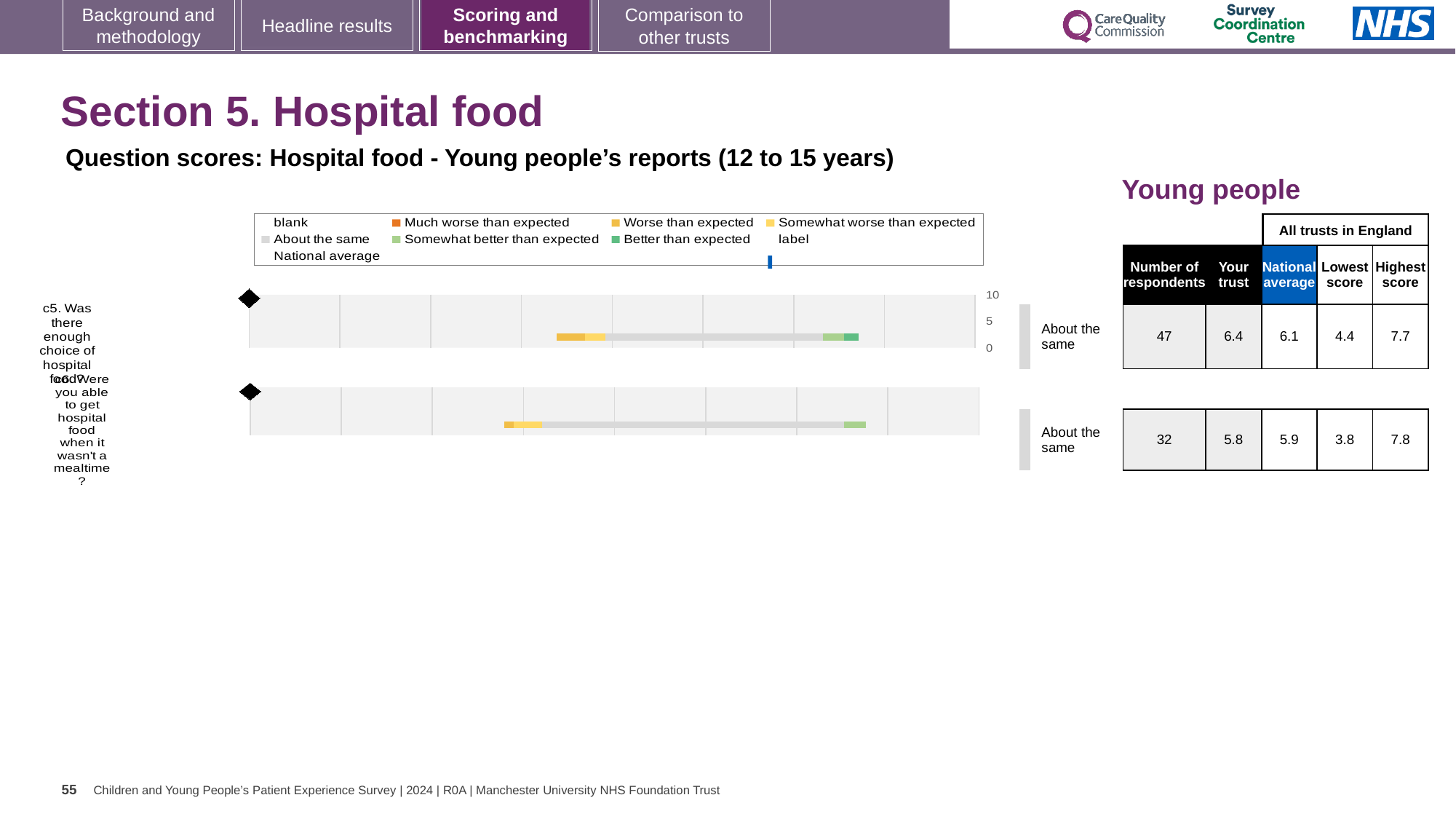
What kind of chart is used to show the question scores for hospital food? bar chart Which question had more respondents, c5 or c6? c5 What is the difference between the highest score and the lowest score for question c5? 3.3 What is the national average score for question c5 (Was there enough choice of hospital food?)? 6.1 How many survey questions are plotted in the hospital food chart? 2 What is the 'Your trust' score for question c5 (Was there enough choice of hospital food?)? 6.4 What is the highest value shown on the score axis of the hospital food chart? 10 For question c6, is the 'Your trust' score or the national average higher? National average For question c5, is the 'Your trust' score or the national average higher? Your trust What is the 'Your trust' score for question c6 (Were you able to get hospital food when it wasn't a mealtime?)? 5.8 What benchmark label is given to the trust's result for question c6? About the same How many respondents answered question c6 (Were you able to get hospital food when it wasn't a mealtime?)? 32